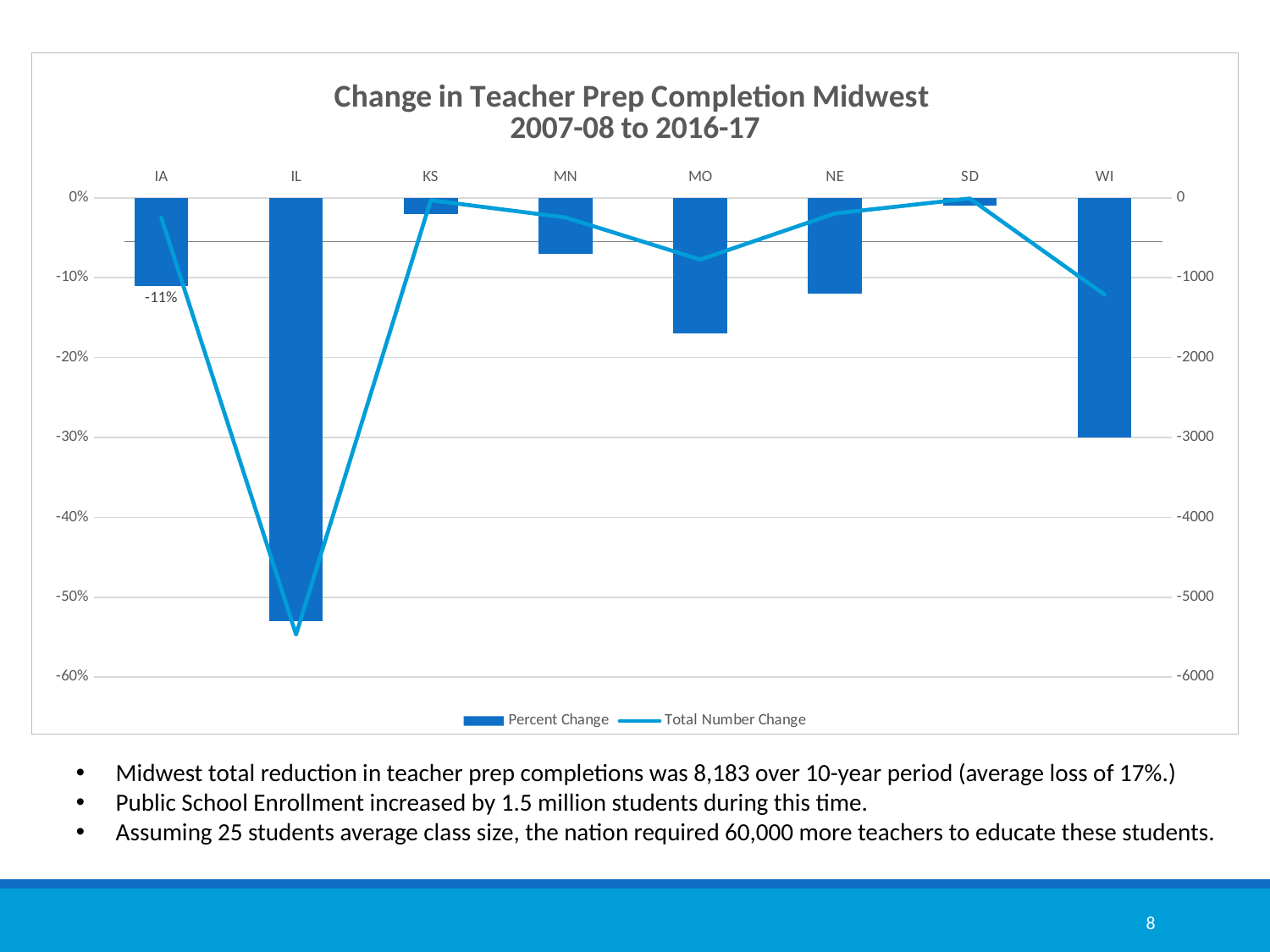
How many states are shown on the x axis of the chart? 8 What is the title of the chart? Change in Teacher Prep Completion Midwest 2007-08 to 2016-17 Is the Total Number Change for WI greater or less than -2000? greater How many series does the legend list? 2 What kind of chart is this? Combined bar and line chart Which state has the largest negative Percent Change? IL What is the Percent Change for IA? -11% Is the Total Number Change for IL greater or less than -5000? less Which state has the lowest Total Number Change on the line? IL Is the Percent Change for WI greater or less than -20%? less Which state shows a larger decline in Percent Change, MO or MN? MO